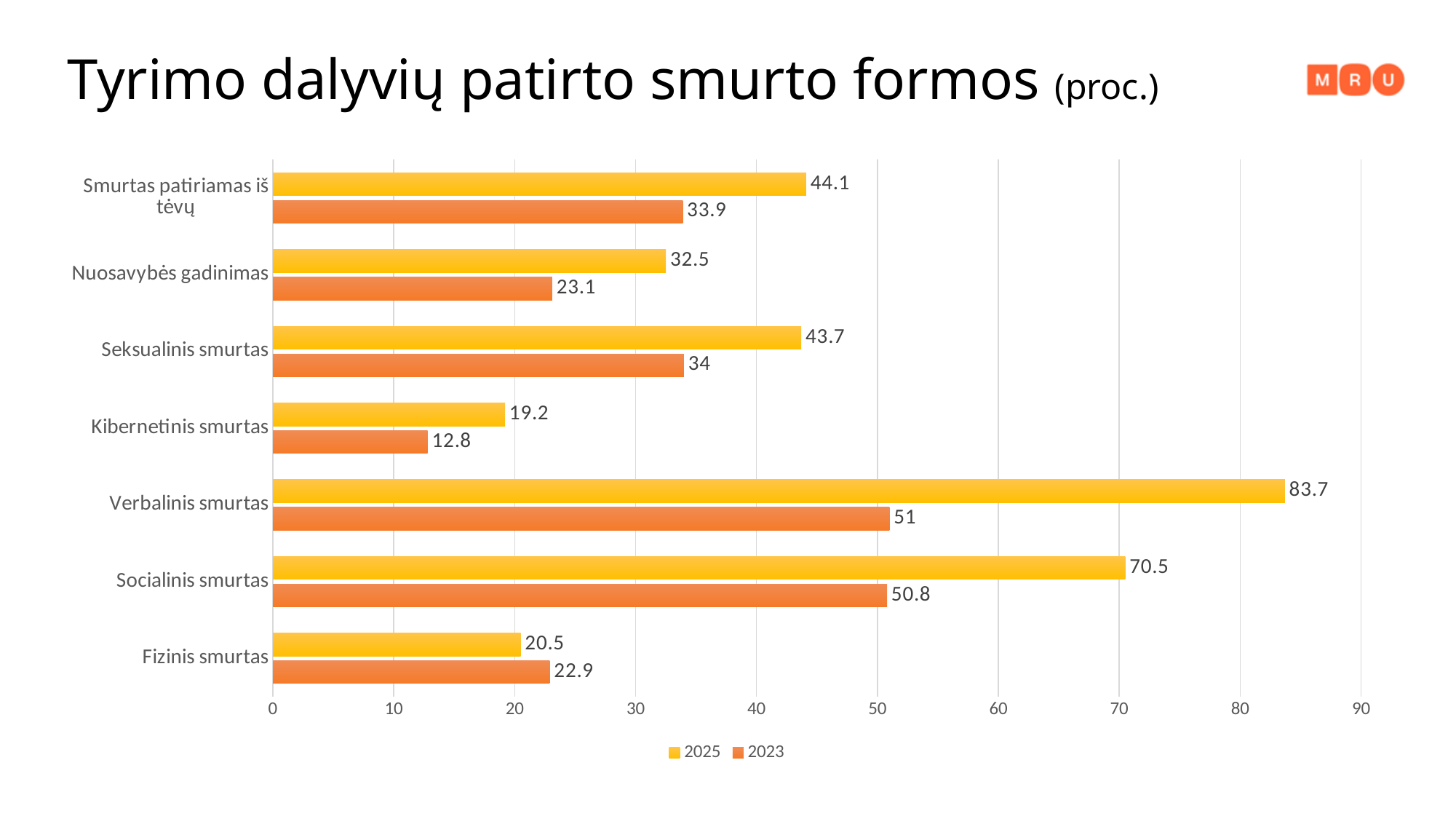
What kind of chart is shown on the slide? Bar chart Which category has the highest 2025 value? Verbalinis smurtas What is the 2025 value for Verbalinis smurtas? 83.7 Is the 2025 value for Socialinis smurtas greater or less than 60? greater What is the difference between the 2025 and 2023 values for Verbalinis smurtas? 32.7 Which colour represents the 2023 series? Orange What is the 2023 value for Socialinis smurtas? 50.8 What is the 2023 value for Kibernetinis smurtas? 12.8 Which category has the lowest 2023 value? Kibernetinis smurtas For Fizinis smurtas, which year has the larger value, 2025 or 2023? 2023 How many categories are shown on the chart? 7 How many series does the legend list? 2